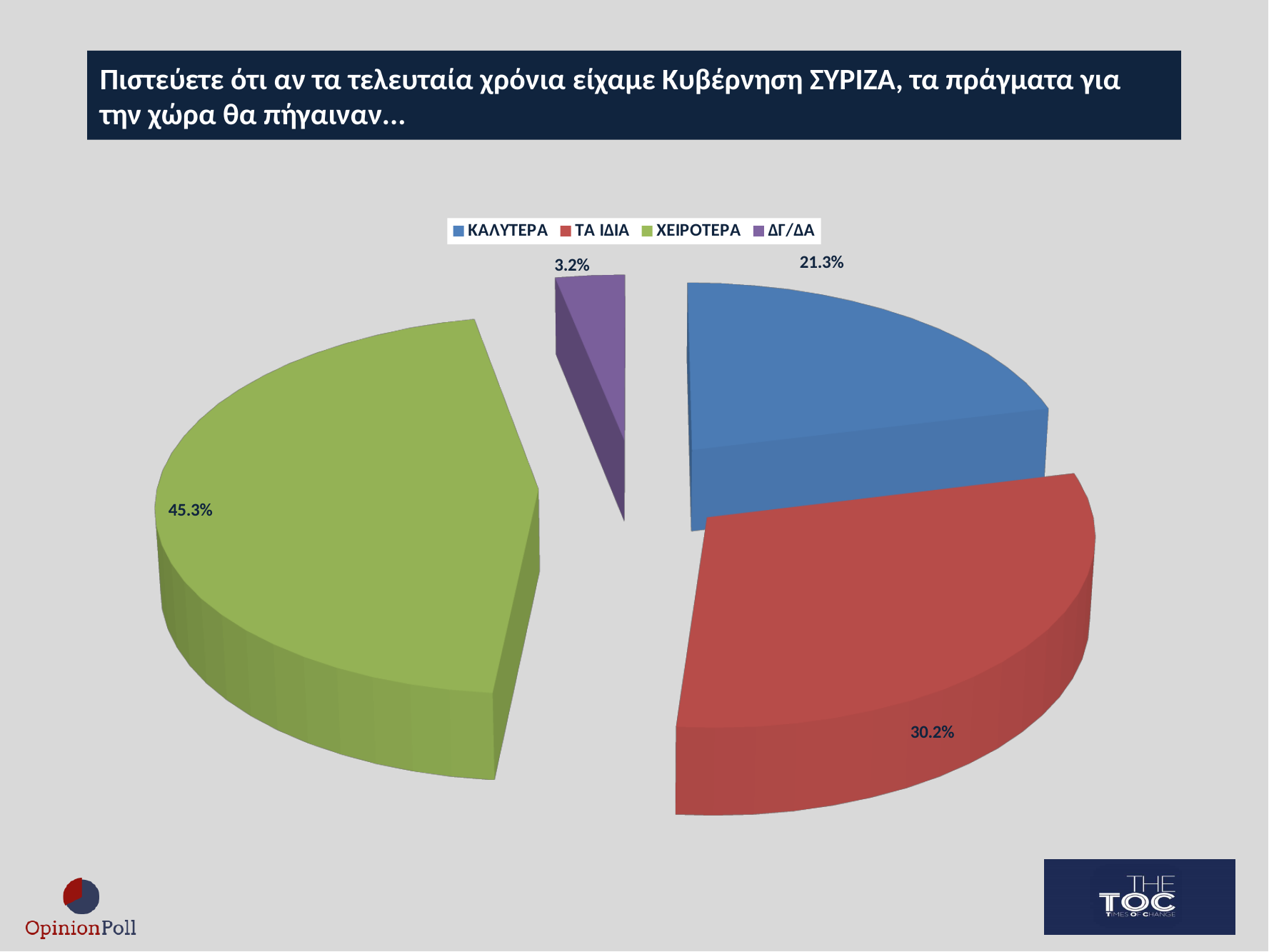
Which category has the largest share of the pie? ΧΕΙΡΟΤΕΡΑ Which category has the smallest share of the pie? ΔΓ/ΔΑ What is the value for ΧΕΙΡΟΤΕΡΑ? 45.3% What kind of chart is shown on the slide? Pie chart What is the difference between the values for ΤΑ ΙΔΙΑ and ΚΑΛΥΤΕΡΑ? 8.9% What colour is the ΧΕΙΡΟΤΕΡΑ slice? Green What is the value for ΤΑ ΙΔΙΑ? 30.2% What is the value for ΔΓ/ΔΑ? 3.2% Which is larger, the value for ΚΑΛΥΤΕΡΑ or the value for ΤΑ ΙΔΙΑ? ΤΑ ΙΔΙΑ How many categories does the legend list? 4 What is the difference between the values for ΧΕΙΡΟΤΕΡΑ and ΤΑ ΙΔΙΑ? 15.1% What is the value for ΚΑΛΥΤΕΡΑ? 21.3%